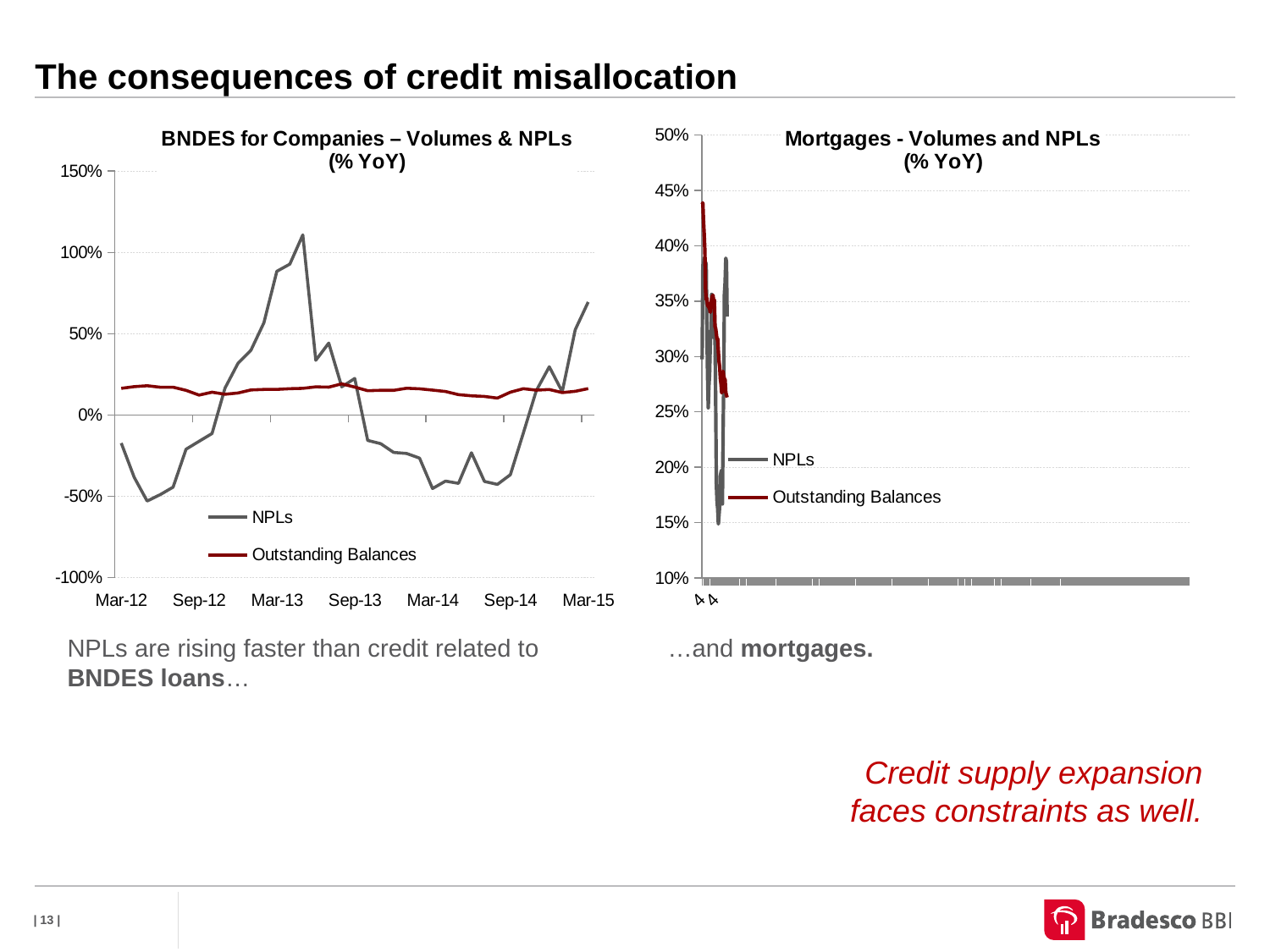
How many series does the legend of the 'BNDES for Companies – Volumes & NPLs (% YoY)' chart list? 2 In the 'BNDES for Companies – Volumes & NPLs (% YoY)' chart, is the NPLs value at Mar-12 greater or less than 0%? less What kind of chart is the 'BNDES for Companies – Volumes & NPLs (% YoY)' chart on the left? line chart In the 'Mortgages - Volumes and NPLs (% YoY)' chart, does the Outstanding Balances series rise or fall overall from its start to its end? fall In the 'BNDES for Companies – Volumes & NPLs (% YoY)' chart, is the NPLs value at Mar-14 greater or less than 0%? less How many series does the legend of the 'Mortgages - Volumes and NPLs (% YoY)' chart list? 2 In the 'Mortgages - Volumes and NPLs (% YoY)' chart, is the starting value of the Outstanding Balances series greater or less than 40%? greater In the 'BNDES for Companies – Volumes & NPLs (% YoY)' chart, which series is drawn in dark red? Outstanding Balances What kind of chart is the 'Mortgages - Volumes and NPLs (% YoY)' chart on the right? line chart